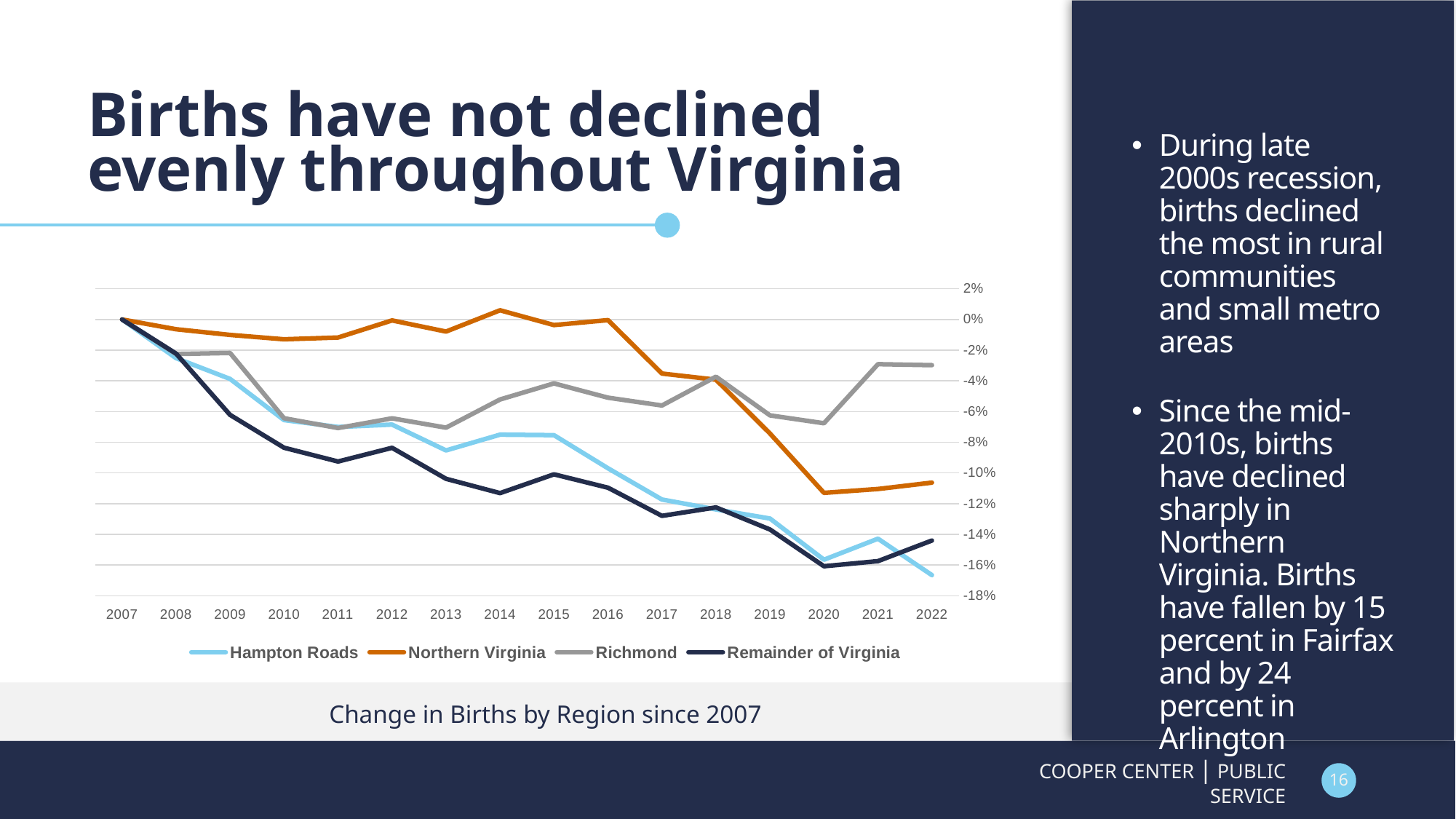
Which series has the lowest value in 2022? Hampton Roads How many years are shown along the x axis? 16 In 2022, which is higher: Richmond or Northern Virginia? Richmond Which series has the highest value in 2014? Northern Virginia What is the value for Northern Virginia in 2007? 0% How many series does the legend list? 4 Is the value for Hampton Roads in 2022 greater or less than -14%? less Is the value for Northern Virginia in 2020 greater or less than -10%? less What kind of chart is shown on the slide? line chart What is the caption shown below the chart? Change in Births by Region since 2007 Is the value for Remainder of Virginia in 2011 greater or less than -8%? less